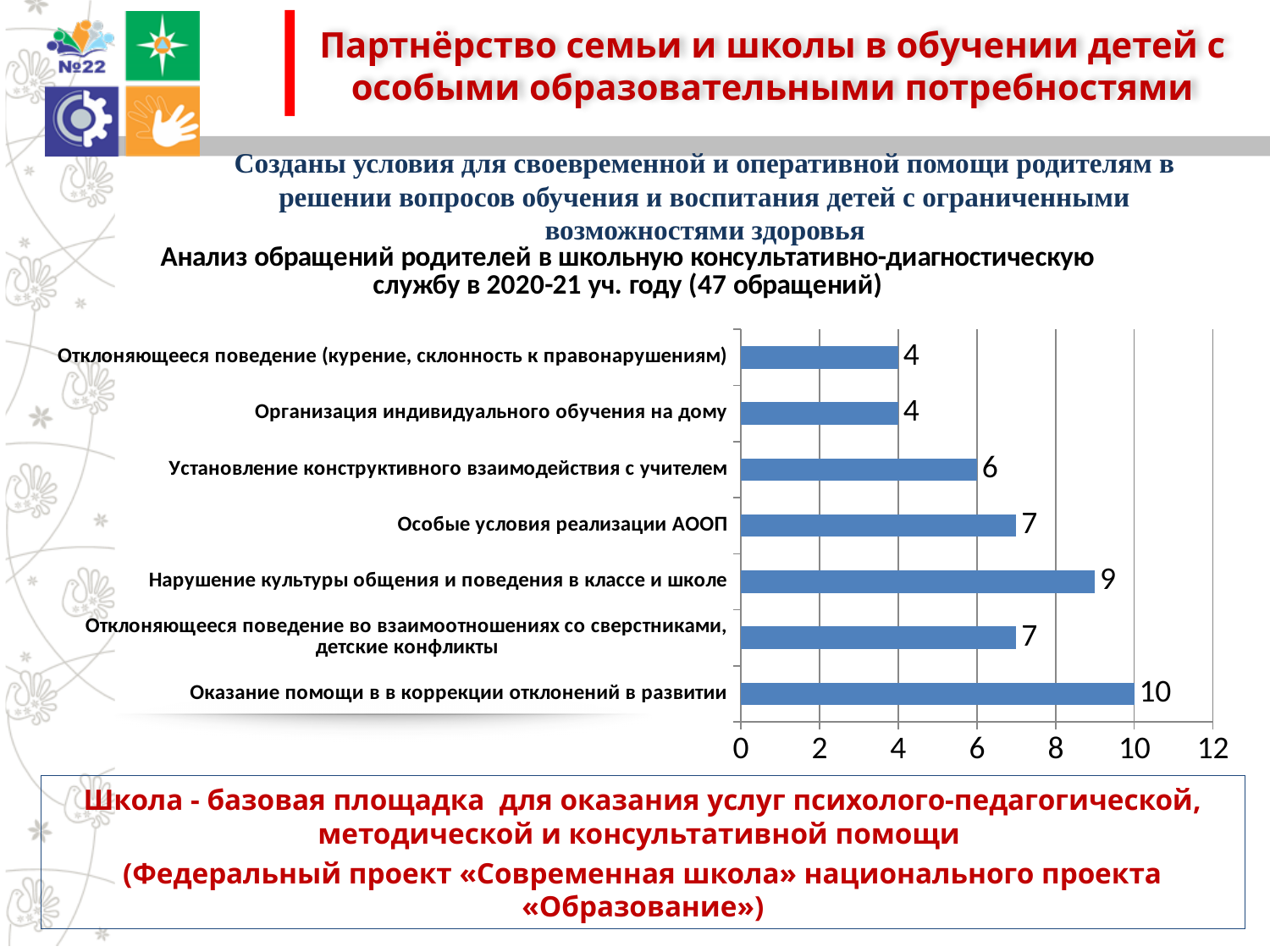
According to the chart heading, how many parent requests (обращений) were analysed in the 2020-21 academic year? 47 What value is shown for «Оказание помощи в в коррекции отклонений в развитии»? 10 What value is shown for «Организация индивидуального обучения на дому»? 4 What is the difference between the values for «Особые условия реализации АООП» and «Отклоняющееся поведение (курение, склонность к правонарушениям)»? 3 What kind of chart is shown on the slide? Bar chart What value is shown for «Установление конструктивного взаимодействия с учителем»? 6 What is the maximum value shown on the horizontal axis of the chart? 12 What is the difference between the values for «Оказание помощи в в коррекции отклонений в развитии» and «Нарушение культуры общения и поведения в классе и школе»? 1 How many categories are shown in the chart? 7 Which is larger: the value for «Установление конструктивного взаимодействия с учителем» or the value for «Нарушение культуры общения и поведения в классе и школе»? Нарушение культуры общения и поведения в классе и школе Which category has the highest value? Оказание помощи в в коррекции отклонений в развитии What value is shown for «Нарушение культуры общения и поведения в классе и школе»? 9